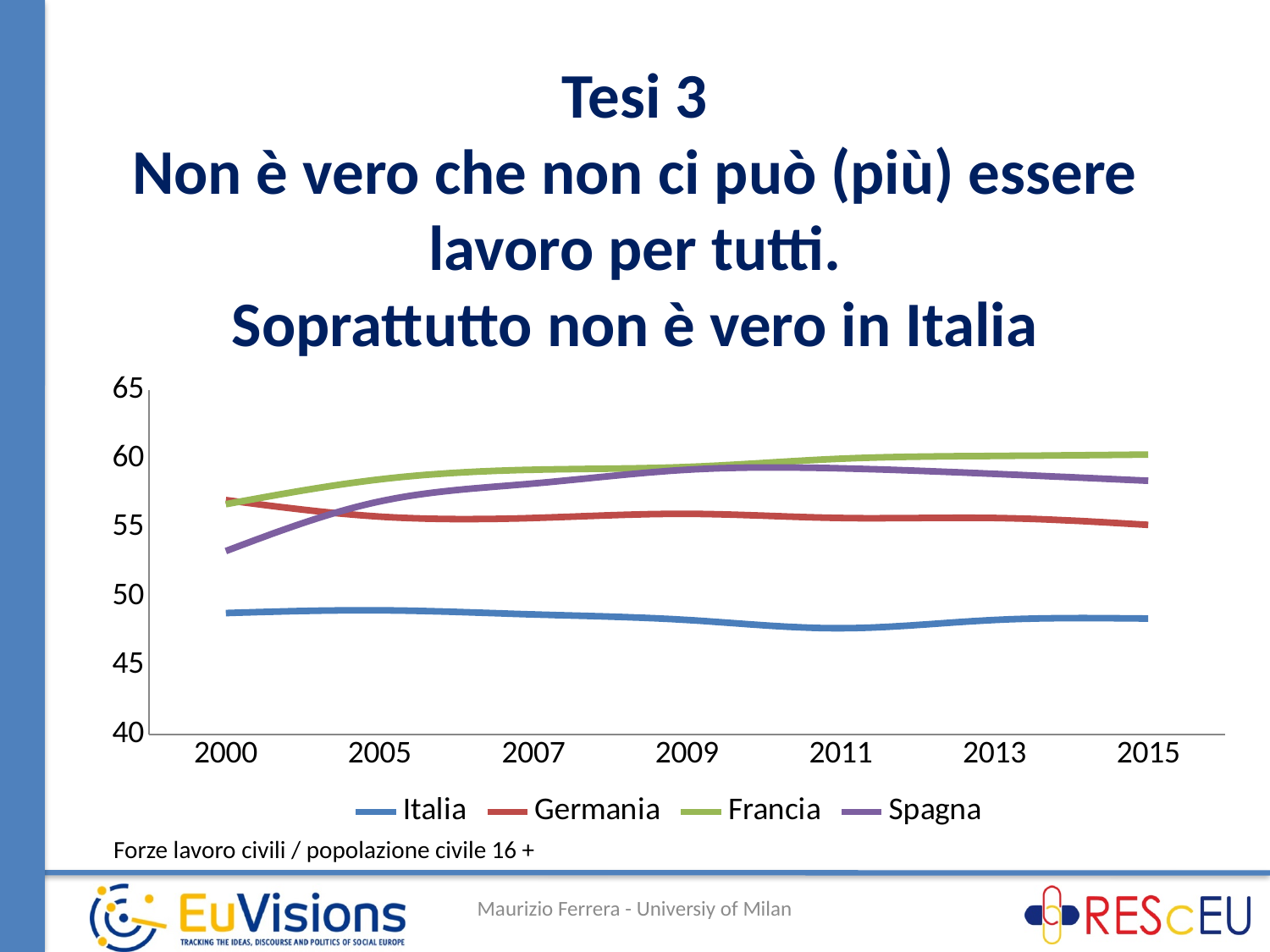
Which series has the highest value in 2015? Francia Is the value for Francia in 2015 greater or less than 55? greater How many series does the legend list? 4 Is the value for Spagna in 2000 greater or less than 55? less Is the value for Italia in 2000 greater or less than 50? less Which series has the lowest value in 2000? Italia What note is printed below the legend describing the measure plotted? Forze lavoro civili / popolazione civile 16 + Does the Italia line rise or fall from 2000 to 2011? fall In 2000, which is larger: the value for Germania or the value for Spagna? Germania Which series has the lowest value in 2015? Italia How many years are labelled on the x axis? 7 What kind of chart is shown on the slide? line chart